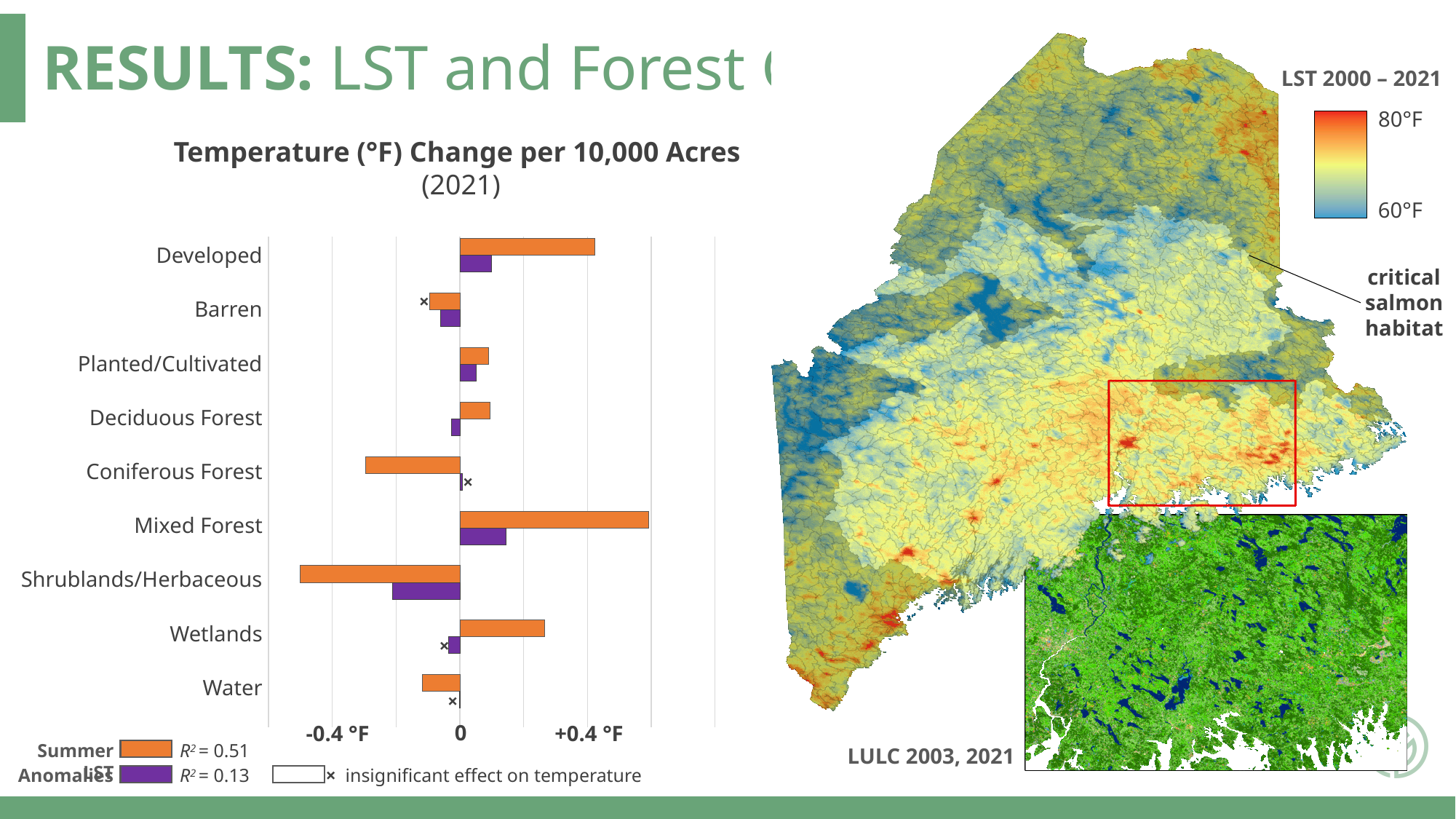
Which category has the highest Summer temperature change in the bar chart? Mixed Forest What kind of chart is shown on the left of the slide? Bar chart Which category has the lowest Summer temperature change in the bar chart? Shrublands/Herbaceous Is the Summer value for Mixed Forest greater or less than +0.4 °F? greater How many land-cover categories are plotted in the bar chart? 9 What R² value is given for the Summer series in the legend? R² = 0.51 Is the Summer value for Shrublands/Herbaceous greater or less than -0.4 °F? less Which category has the lowest LST Anomalies value in the bar chart? Shrublands/Herbaceous Which has the larger Summer temperature change, Developed or Wetlands? Developed How many series does the bar chart's legend list? 2 Is the Summer value for Coniferous Forest greater or less than 0? less According to the legend, what does the × symbol next to a bar indicate? Insignificant effect on temperature